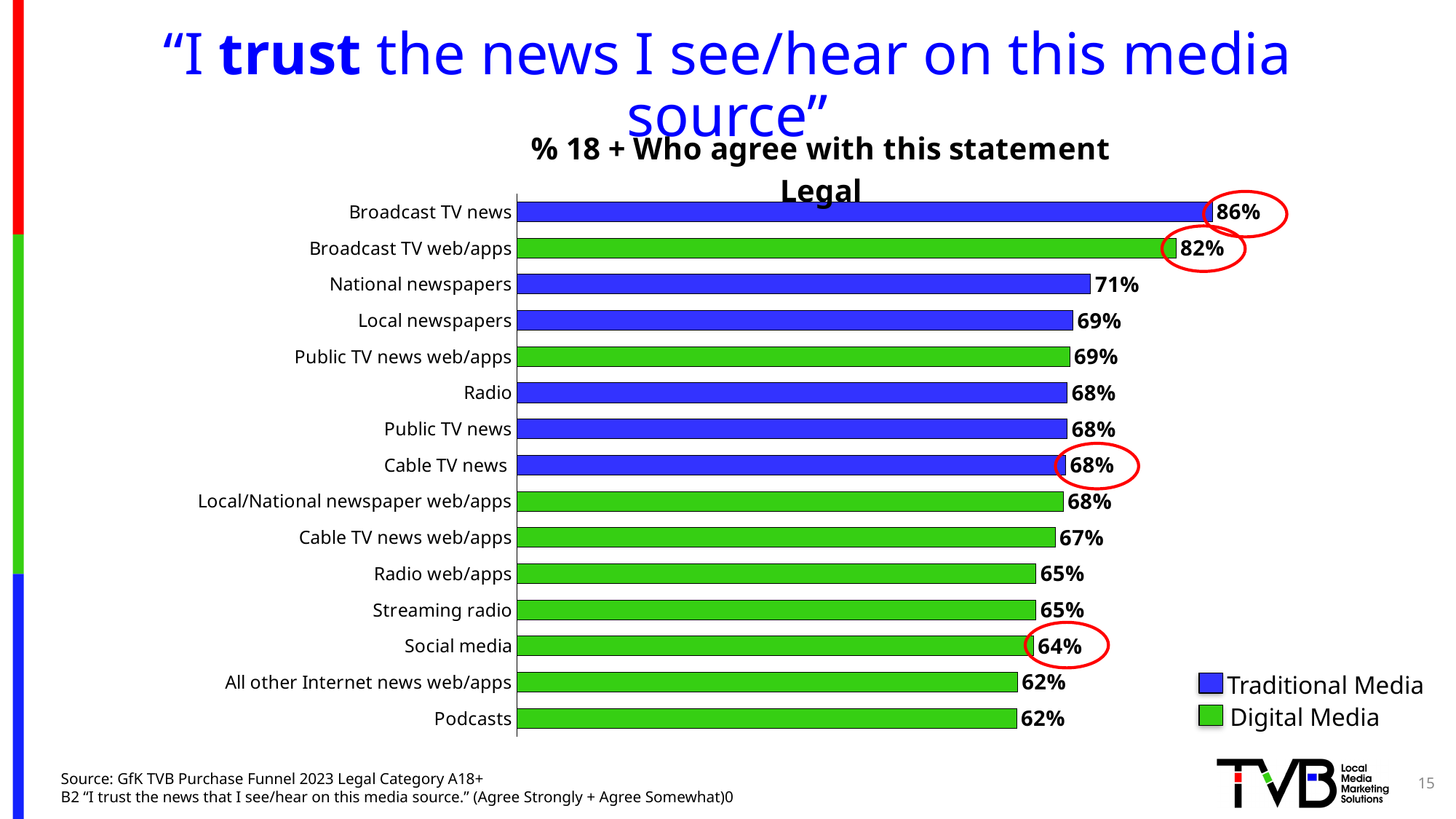
What type of chart is shown on the slide? Bar chart What is the value shown for Social media? 64% What is the difference between the values for National newspapers and Podcasts? 9 percentage points What is the value shown for National newspapers? 71% How many media sources are listed on the chart? 15 Which has a higher value, Cable TV news web/apps or Radio web/apps? Cable TV news web/apps How many series does the legend list? 2 Which media source has the highest percentage of agreement? Broadcast TV news What percentage of adults 18+ agree they trust the news on Broadcast TV news? 86% What colour represents Digital Media in the legend? Green What is the value shown for Streaming radio? 65% What is the difference in percentage points between Broadcast TV news and Broadcast TV web/apps? 4 percentage points